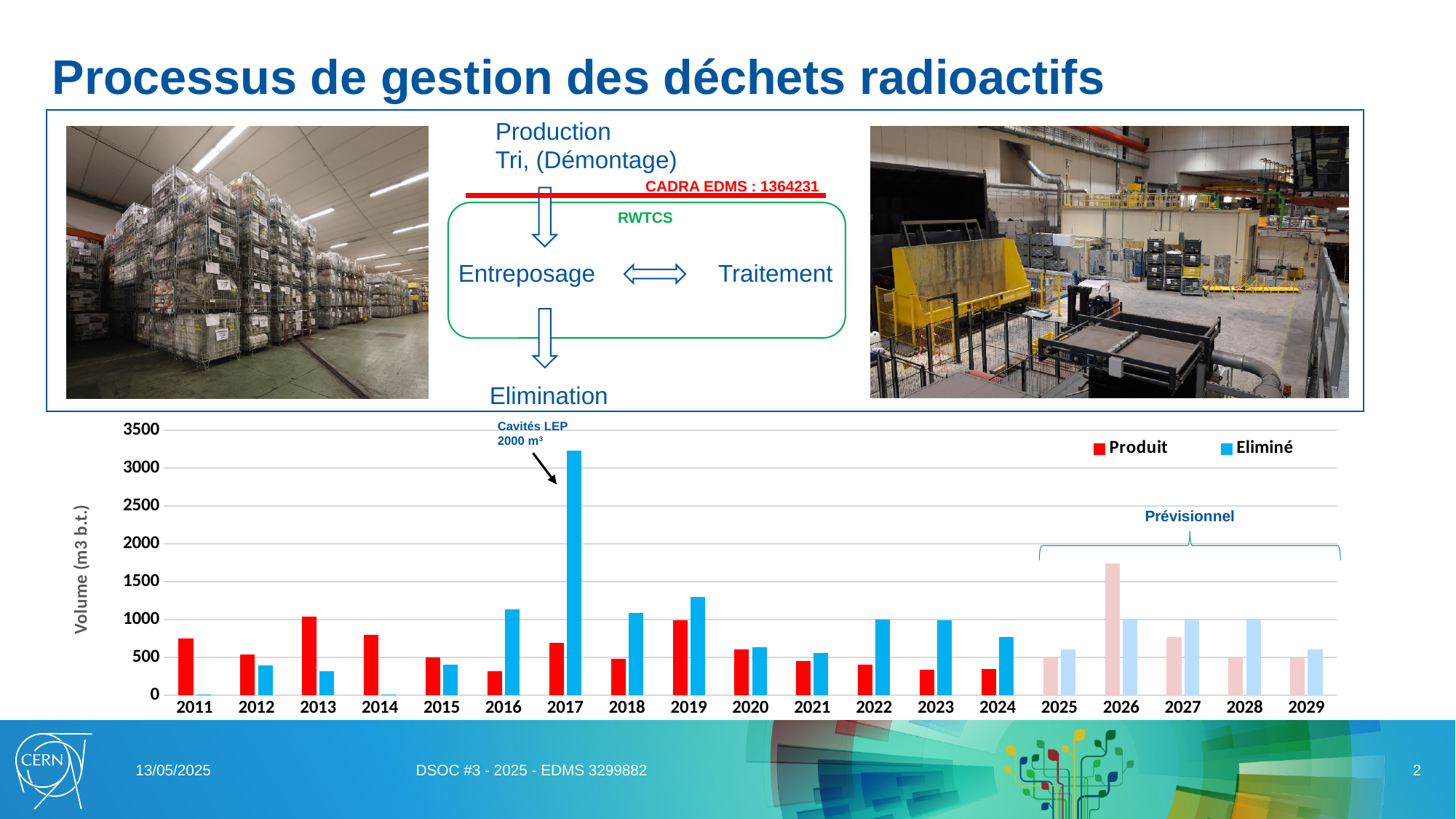
Is the Produit value for 2026 greater or less than 1500? greater Is the Produit value for 2011 greater or less than 1000? less What kind of chart is shown at the bottom of the slide? bar chart How many series does the legend of the bar chart list? 2 In 2013, which is larger, the Produit value or the Eliminé value? Produit In which year is the Produit value highest in the bar chart? 2026 What are the two series named in the legend of the bar chart? Produit and Eliminé Is the Eliminé value for 2017 greater or less than 3000? greater In which year is the Eliminé value highest in the bar chart? 2017 What is the label of the y axis of the bar chart? Volume (m3 b.t.) How many years are shown on the x axis of the bar chart? 19